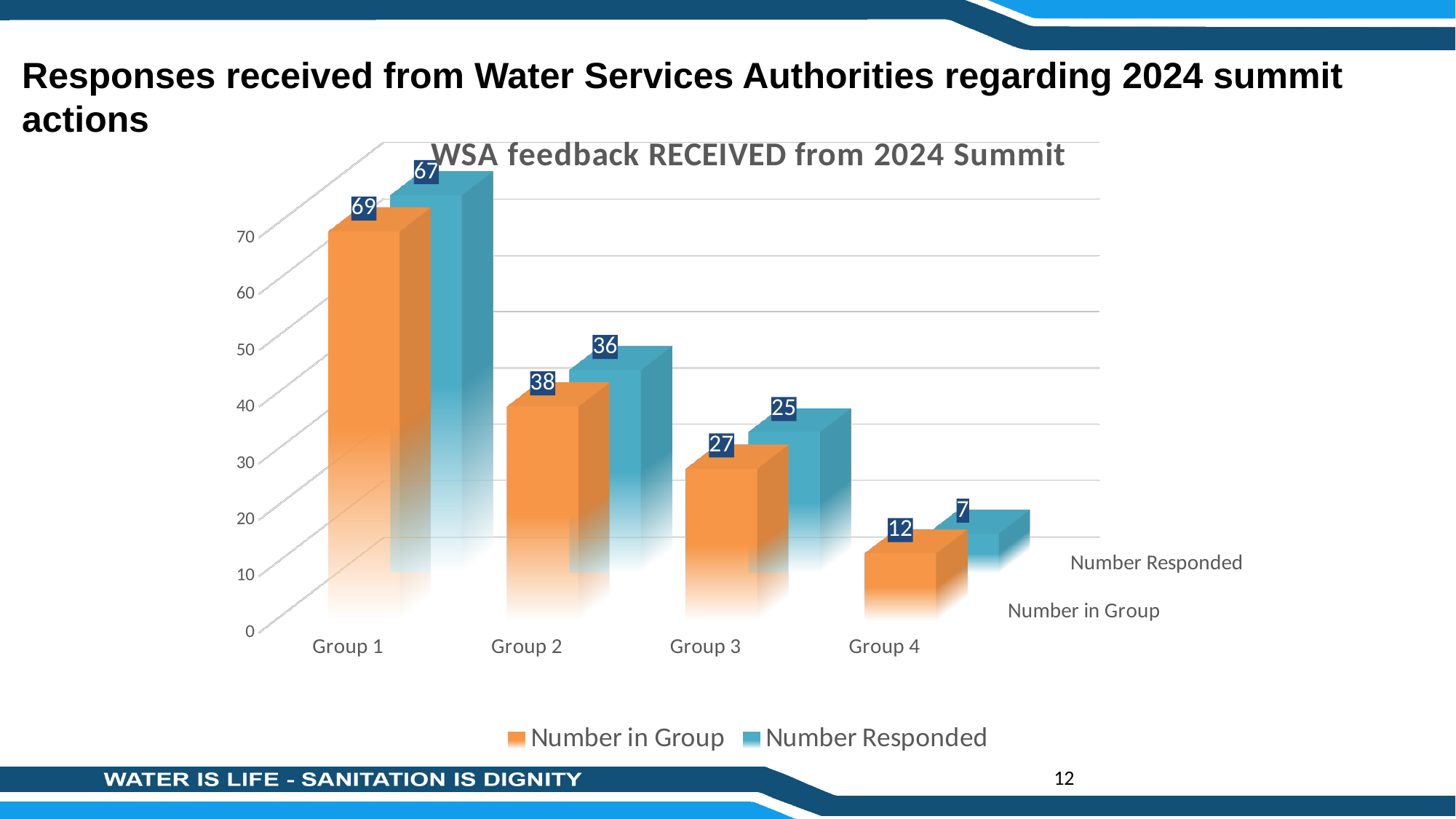
Which is larger for Group 4: Number in Group or Number Responded? Number in Group What is the Number Responded for Group 2? 36 How many groups are shown on the x axis? 4 Which group has the lowest Number in Group? Group 4 What is the difference between the Number in Group for Group 1 and Group 2? 31 Do the Number in Group values rise or fall from Group 1 to Group 4? Fall What kind of chart is shown? Bar chart What is the Number in Group for Group 1? 69 What is the difference between Number in Group and Number Responded for Group 3? 2 What is the Number Responded for Group 4? 7 How many series does the legend list? 2 Which group has the highest Number Responded? Group 1